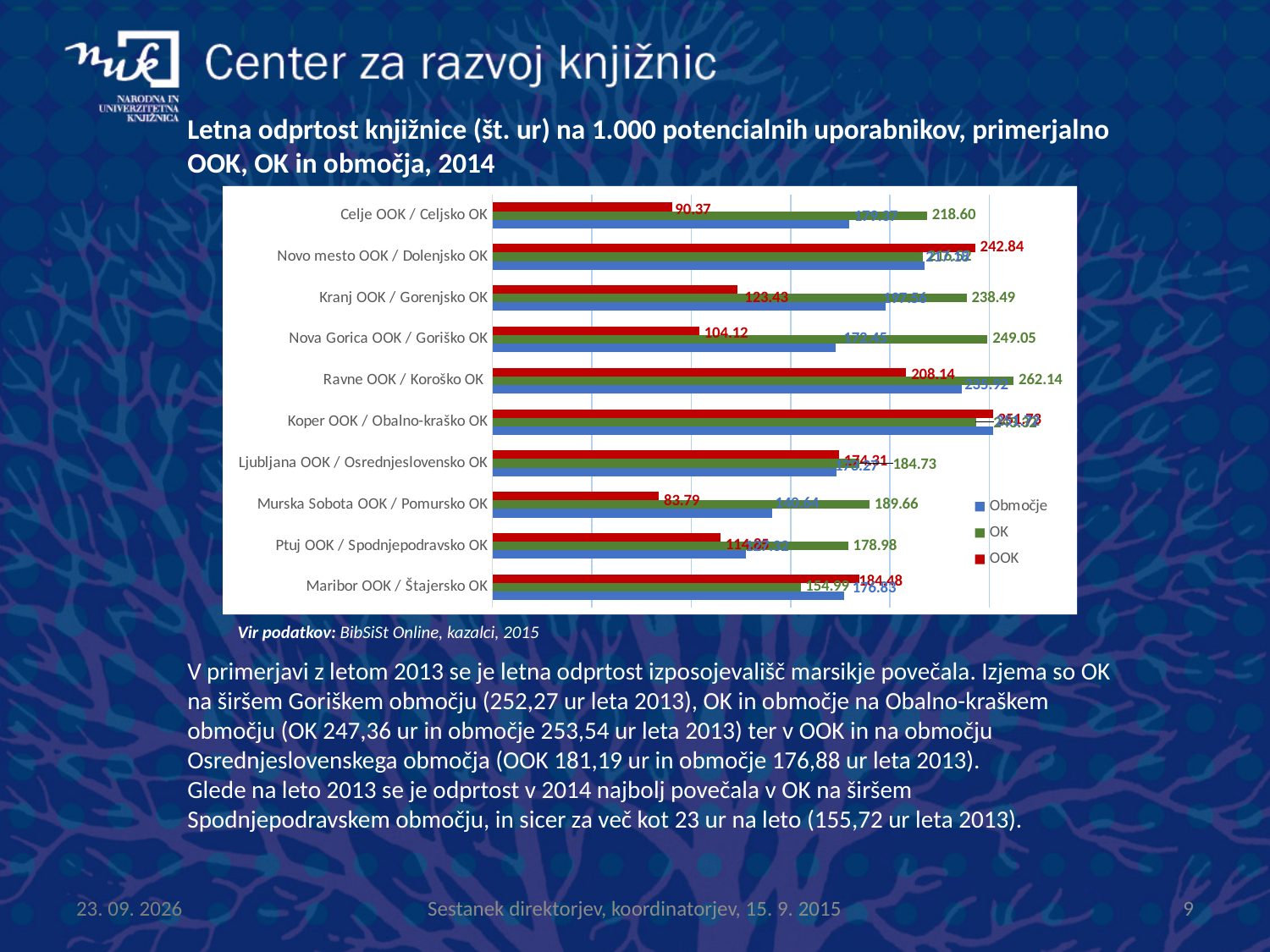
Which is larger: the OK value for Kranj OOK / Gorenjsko OK or the OK value for Nova Gorica OOK / Goriško OK? Nova Gorica OOK / Goriško OK How many categories (library pairs) are shown on the chart? 10 What type of chart is shown on the slide? bar chart Which category has the lowest OOK value? Murska Sobota OOK / Pomursko OK What is the OOK value for Celje OOK / Celjsko OK? 90.37 What is the OK value for Nova Gorica OOK / Goriško OK? 249.05 Which category has the highest OK value? Ravne OOK / Koroško OK How many series does the legend list? 3 What is the OOK value for Novo mesto OOK / Dolenjsko OK? 242.84 What is the difference between the OK and OOK values for Celje OOK / Celjsko OK? 128.23 What is the OK value for Ravne OOK / Koroško OK? 262.14 What is the OOK value for Murska Sobota OOK / Pomursko OK? 83.79